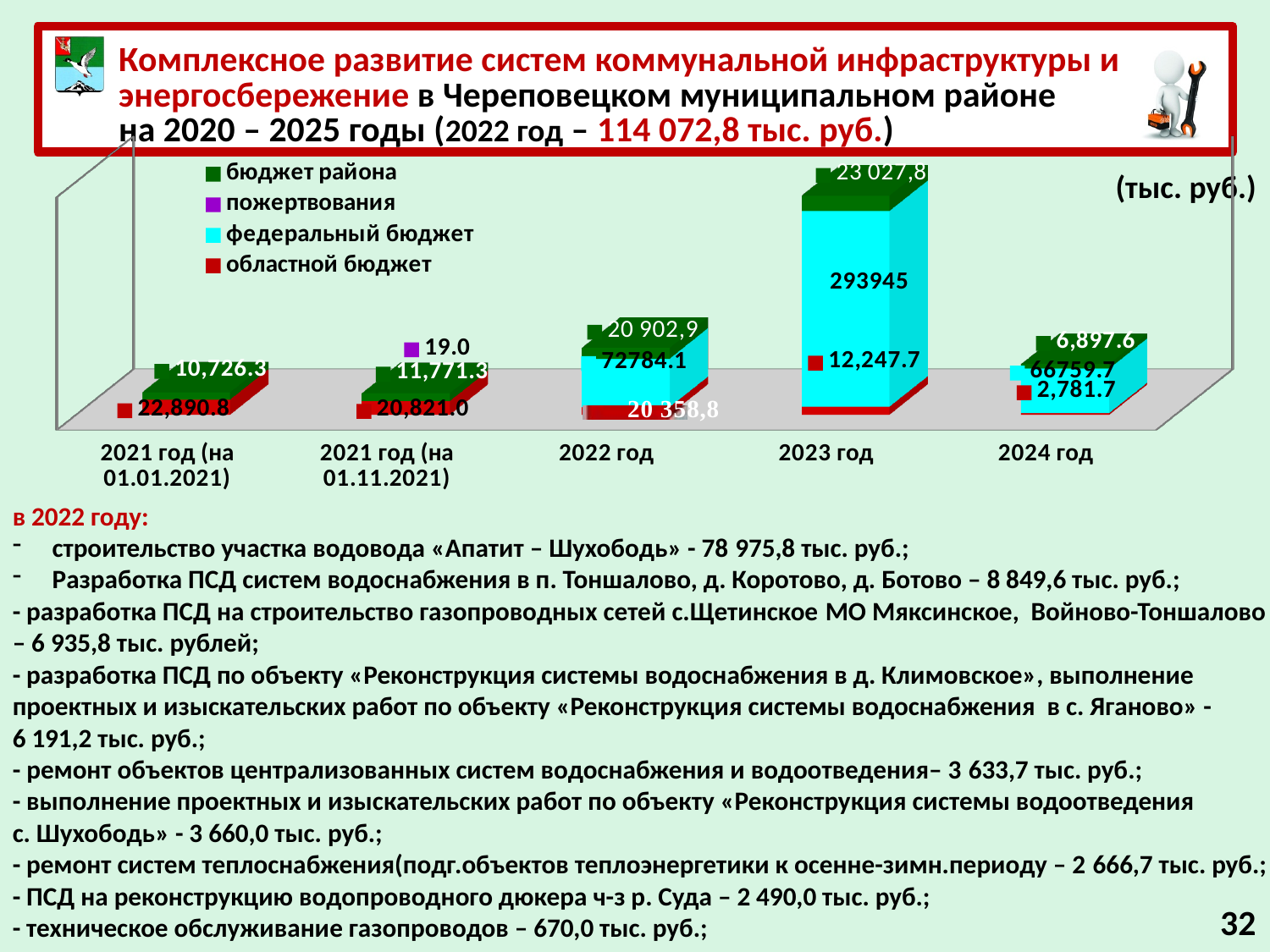
Which legend entry is shown in cyan? федеральный бюджет What is the difference between the областной бюджет values for 2021 год (на 01.01.2021) and 2021 год (на 01.11.2021)? 2,069.8 What kind of chart is shown on the slide? Stacked bar chart How many series does the chart legend list? 4 What is the value of областной бюджет for 2023 год? 12,247.7 What is the value of пожертвования for 2021 год (на 01.11.2021)? 19.0 What is the value of бюджет района for 2024 год? 6,897.6 How many categories are shown along the x axis of the chart? 5 What is the value of федеральный бюджет for 2024 год? 66759.7 In which category is the областной бюджет value the lowest? 2024 год In which year is the федеральный бюджет value the highest? 2023 год Which is larger: the федеральный бюджет value for 2022 год or for 2024 год? 2022 год